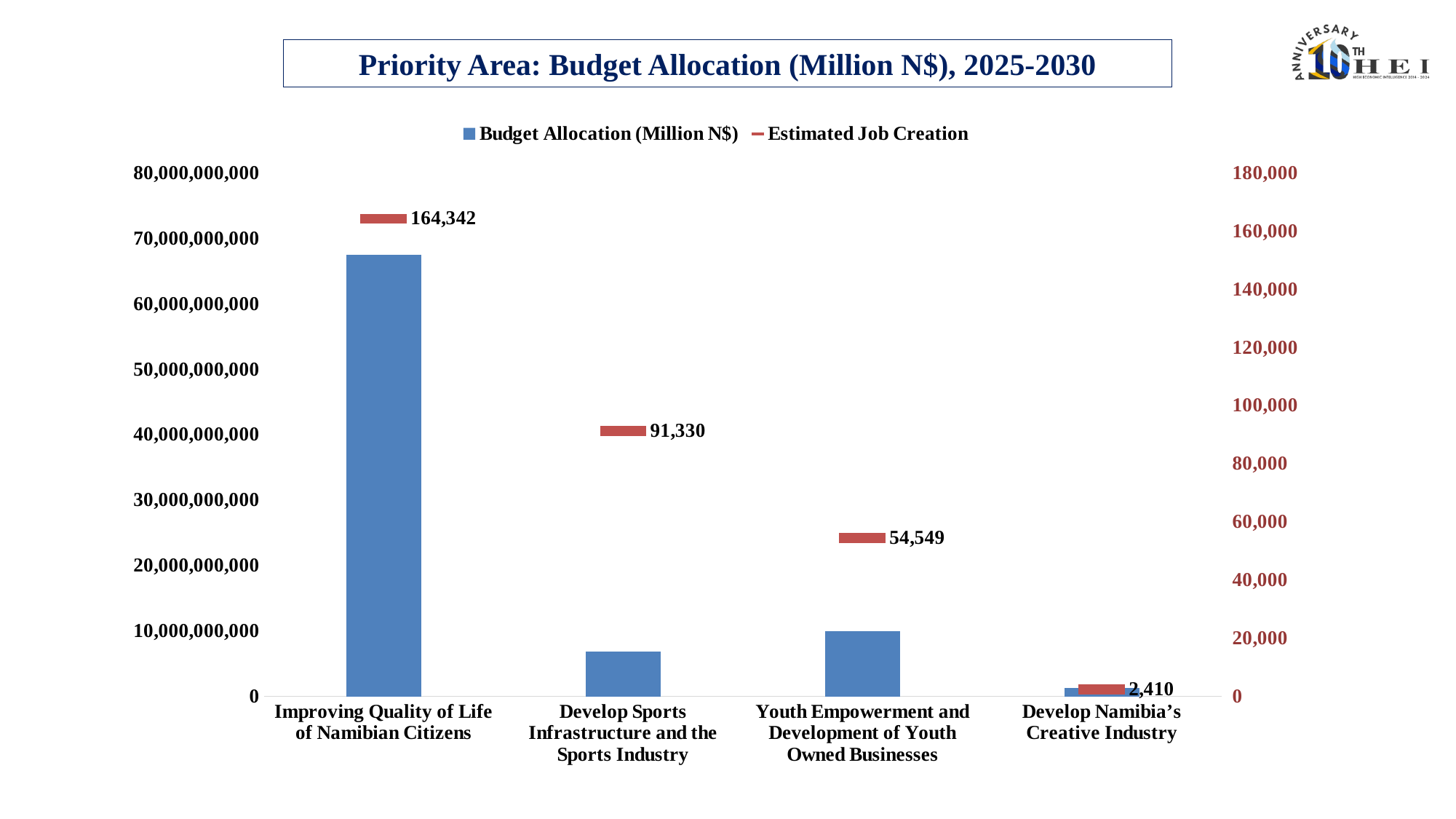
What is the difference in Estimated Job Creation between Improving Quality of Life of Namibian Citizens and Develop Sports Infrastructure and the Sports Industry? 73,012 Which priority area has the lowest Budget Allocation? Develop Namibia's Creative Industry What is the Estimated Job Creation value for Develop Namibia's Creative Industry? 2,410 Which has a larger Budget Allocation: Develop Sports Infrastructure and the Sports Industry or Youth Empowerment and Development of Youth Owned Businesses? Youth Empowerment and Development of Youth Owned Businesses How many series does the legend list? 2 Is the Budget Allocation for Develop Sports Infrastructure and the Sports Industry greater or less than 10,000,000,000? less How many priority areas are shown on the x axis? 4 Is the Budget Allocation for Improving Quality of Life of Namibian Citizens greater or less than 60,000,000,000? greater What is the Estimated Job Creation value for Develop Sports Infrastructure and the Sports Industry? 91,330 Which priority area has the highest Estimated Job Creation? Improving Quality of Life of Namibian Citizens What is the Estimated Job Creation value for Youth Empowerment and Development of Youth Owned Businesses? 54,549 What is the Estimated Job Creation value for Improving Quality of Life of Namibian Citizens? 164,342